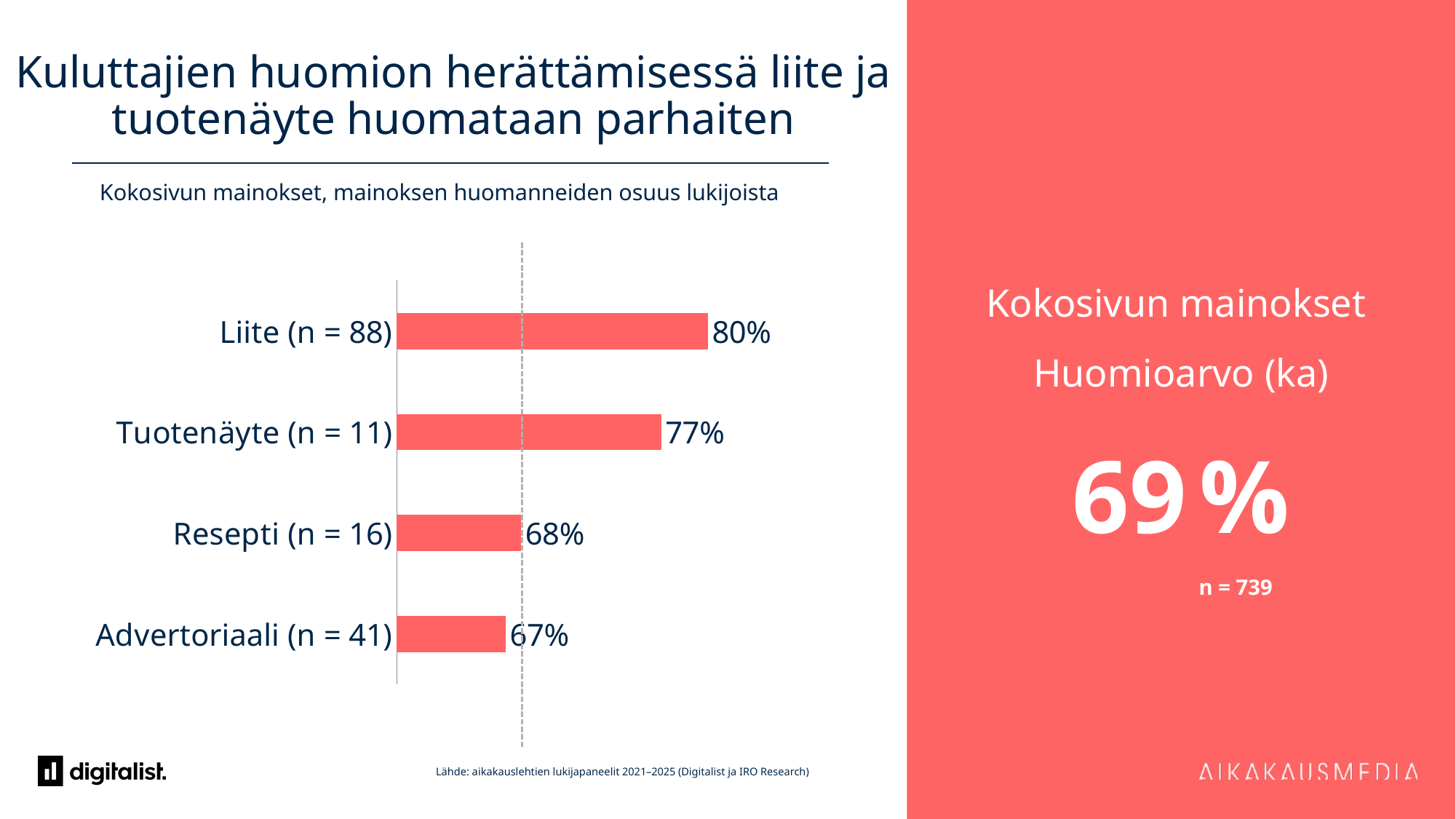
What is the value for Liite (n = 88)? 80% What is the average attention value (Huomioarvo) shown for Kokosivun mainokset on the right panel? 69 % What is the value for Tuotenäyte (n = 11)? 77% Which is larger, the value for Liite (n = 88) or the value for Tuotenäyte (n = 11)? Liite (n = 88) What is the difference between the values for Liite (n = 88) and Advertoriaali (n = 41)? 13 percentage points What is the difference between the values for Tuotenäyte (n = 11) and Resepti (n = 16)? 9 percentage points Which category has the highest value? Liite (n = 88) What is the value for Advertoriaali (n = 41)? 67% Which category has the lowest value? Advertoriaali (n = 41) What kind of chart is shown on the slide? Bar chart How many categories are shown in the chart? 4 What is the value for Resepti (n = 16)? 68%